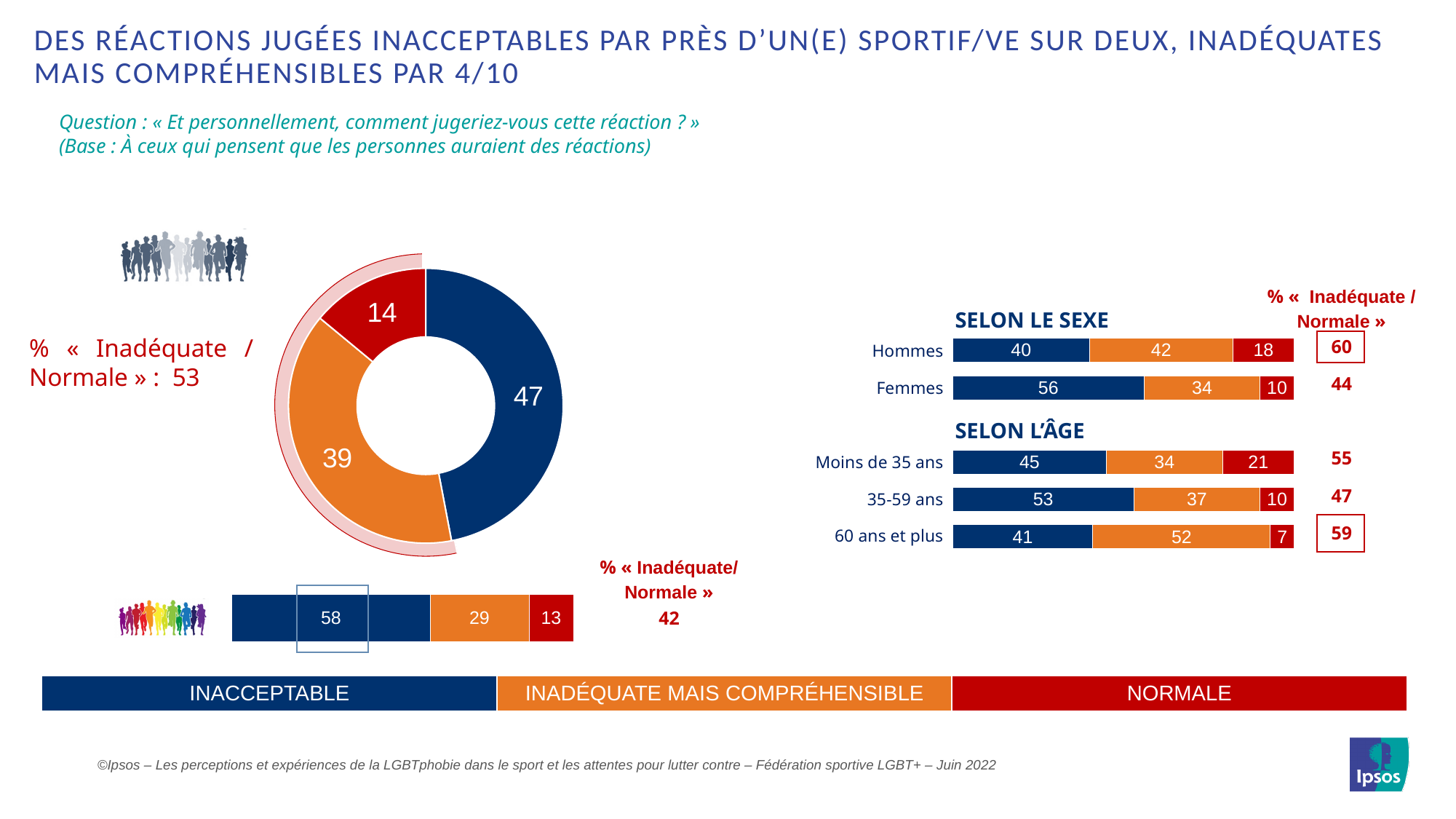
In the donut chart on the left, which segment is the largest? Inacceptable In the 'Selon le sexe' chart, which group has the higher 'Inacceptable' value, Hommes or Femmes? Femmes What type of chart is used for the 'Selon le sexe' and 'Selon l'âge' data? Stacked bar chart In the stacked bar at the bottom left (rainbow figures), what is the total of the three segments? 100 In the stacked bar at the bottom left (rainbow figures), what is the value for 'Inacceptable'? 58 In the 'Selon le sexe' chart, what is the 'Inadéquate mais compréhensible' value for Hommes? 42 In the donut chart on the left, what is the value for the 'Normale' segment? 14 How many age categories are shown in the 'Selon l'âge' chart? 3 In the donut chart on the left, what is the value for the 'Inacceptable' segment? 47 In the 'Selon l'âge' chart, what is the 'Normale' value for 'Moins de 35 ans'? 21 In the donut chart on the left, what is the difference between the 'Inacceptable' and 'Inadéquate mais compréhensible' values? 8 In the 'Selon l'âge' chart, which age group has the highest 'Inadéquate mais compréhensible' value? 60 ans et plus